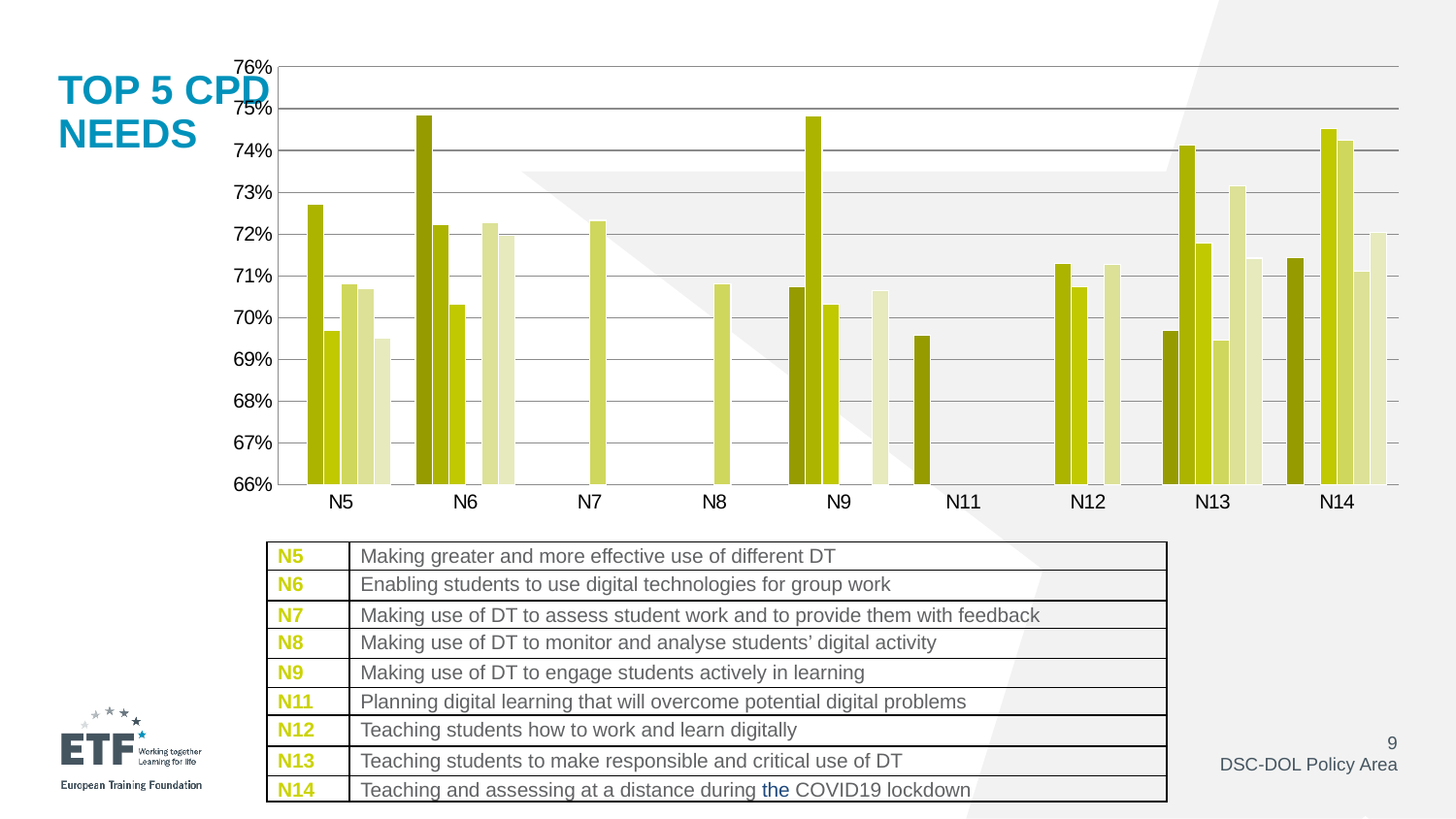
Is the value of the single bar for N8 greater or less than 70%? greater What is the lowest value shown on the y axis of the chart? 66% Is the value of the single bar for N7 greater or less than 70%? greater Is the tallest bar in the N6 group greater or less than 74%? greater What kind of chart is shown on the slide? bar chart Which has the larger value: the bar for N7 or the bar for N11? N7 Which has the larger value: the bar for N8 or the bar for N11? N8 How many bars are plotted for category N5? 5 What is the title shown next to the chart on the slide? TOP 5 CPD NEEDS How many categories are shown on the x axis of the chart? 9